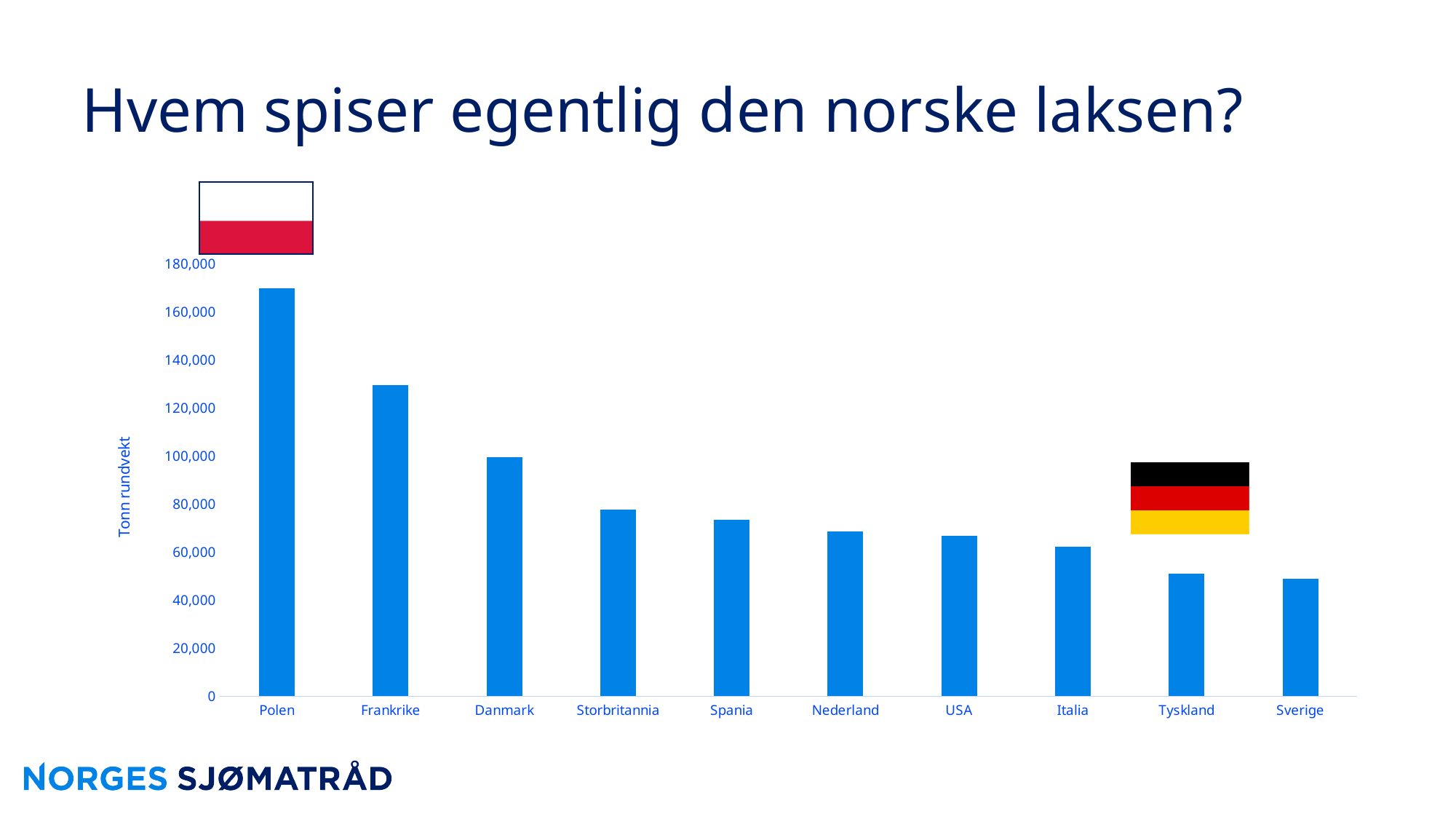
How many countries are shown on the x axis of the chart? 10 What is the label on the vertical axis of the chart? Tonn rundvekt Is the value for Frankrike greater or less than 120,000? greater Which is larger, the value for Frankrike or the value for Danmark? Frankrike Is the value for Sverige greater or less than 40,000? greater Which country has the highest bar in the chart? Polen Is the value for Spania greater or less than 60,000? greater Do the bar values rise or fall from left to right along the x axis? fall What kind of chart is shown on the slide? bar chart